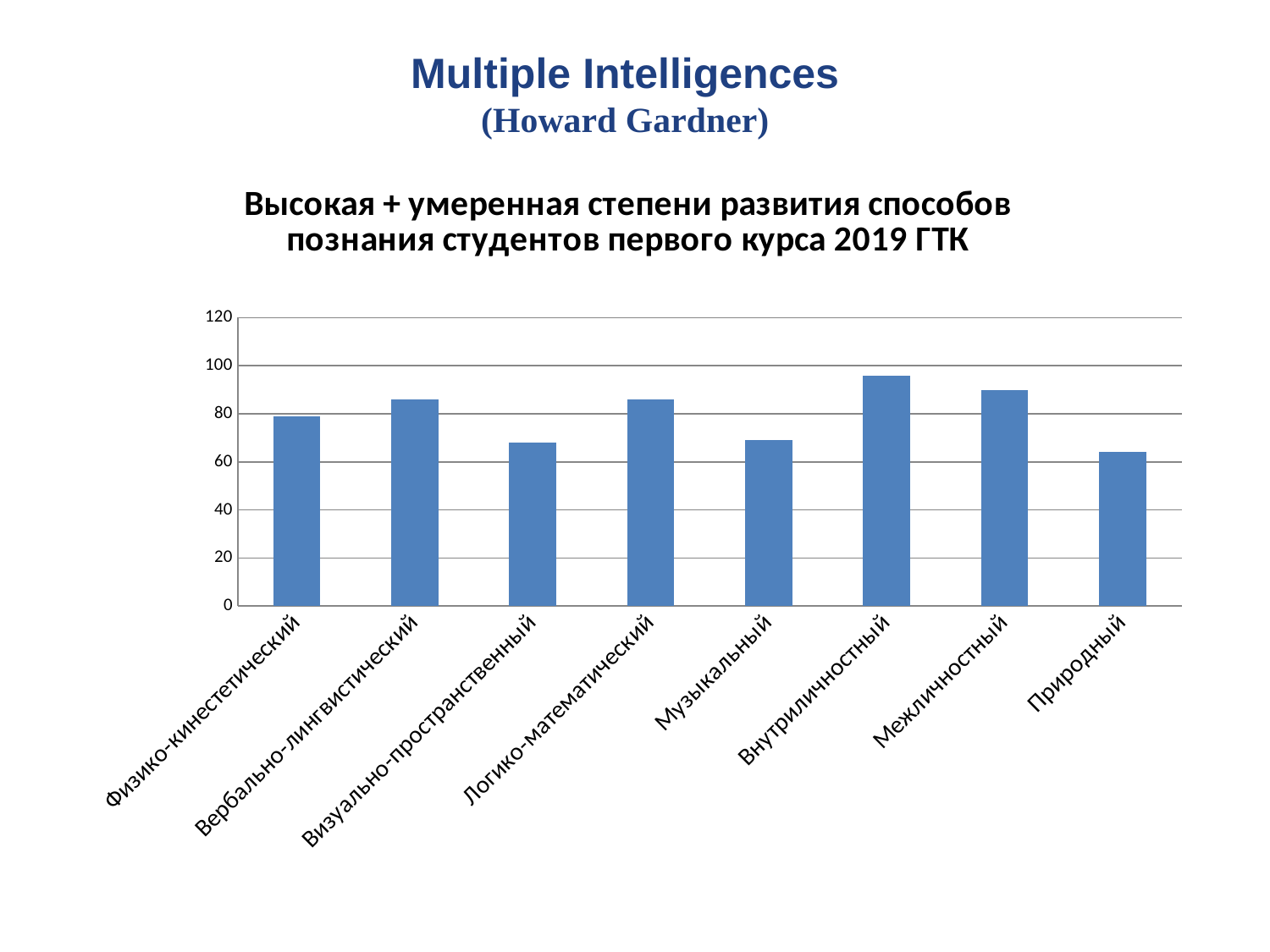
Which is larger, the value for Вербально-лингвистический or the value for Визуально-пространственный? Вербально-лингвистический What is the title of the chart? Высокая + умеренная степени развития способов познания студентов первого курса 2019 ГТК How many categories are shown on the x axis of the chart? 8 Is the value for Музыкальный greater or less than 60? greater Is the value for Физико-кинестетический greater or less than 100? less Which is larger, the value for Внутриличностный or the value for Природный? Внутриличностный What kind of chart is shown on the slide? bar chart Is the value for Межличностный greater or less than 80? greater Which category has the highest bar in the chart? Внутриличностный